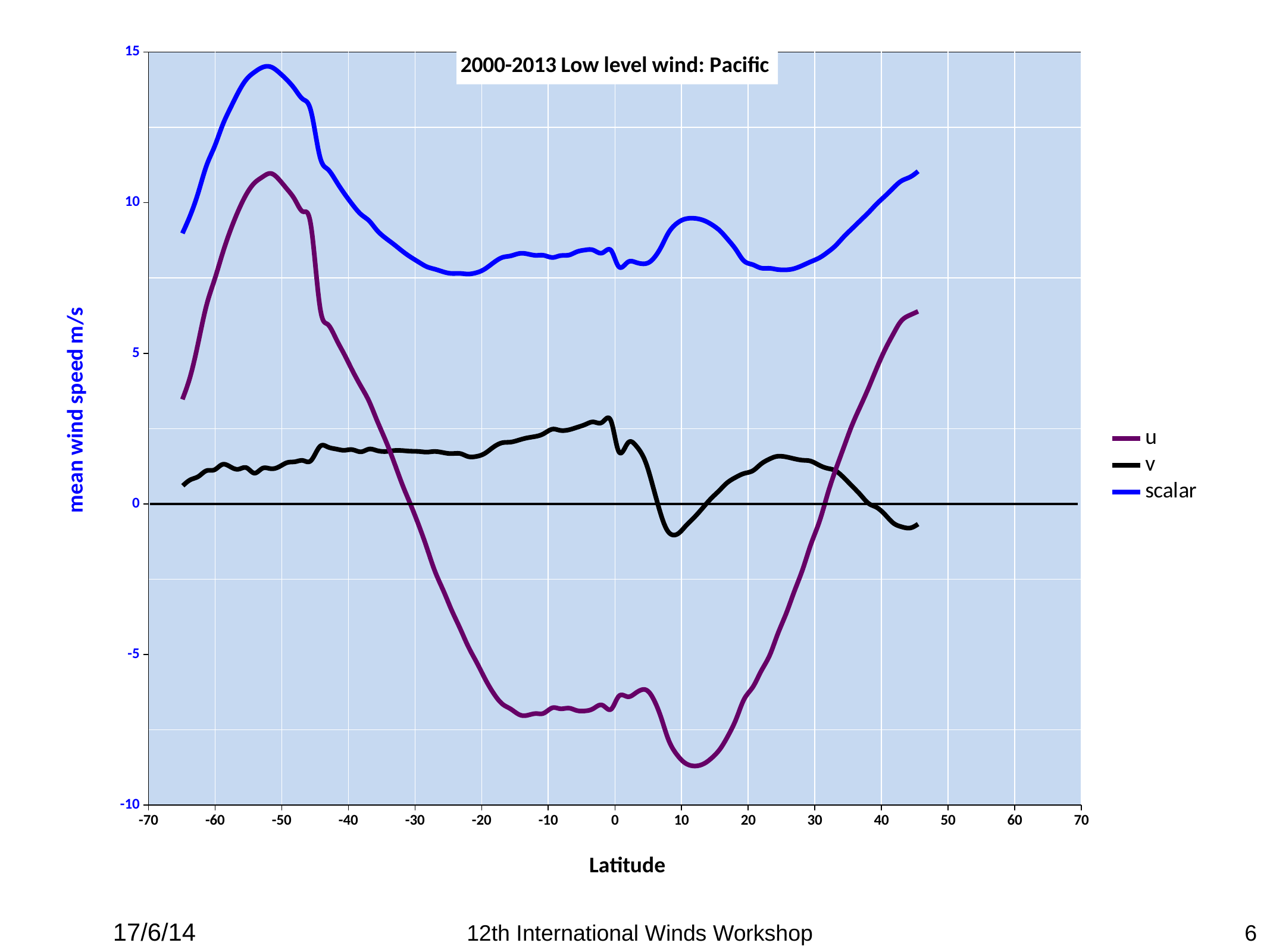
What is the label of the y axis? mean wind speed m/s Which series reaches the highest value on the chart? scalar How many series does the legend list? 3 Which series reaches the lowest value on the chart? u Is the value of the u series at latitude 40 greater or less than 0? greater Is the value of the scalar series at latitude -50 greater or less than 10? greater What is the title of the chart? 2000-2013 Low level wind: Pacific Is the value of the v series at latitude -20 greater or less than 5? less At latitude 10, which series has the larger value, u or v? v What kind of chart is shown on the slide? line chart Does the u series rise or fall between latitude -40 and latitude -20? fall